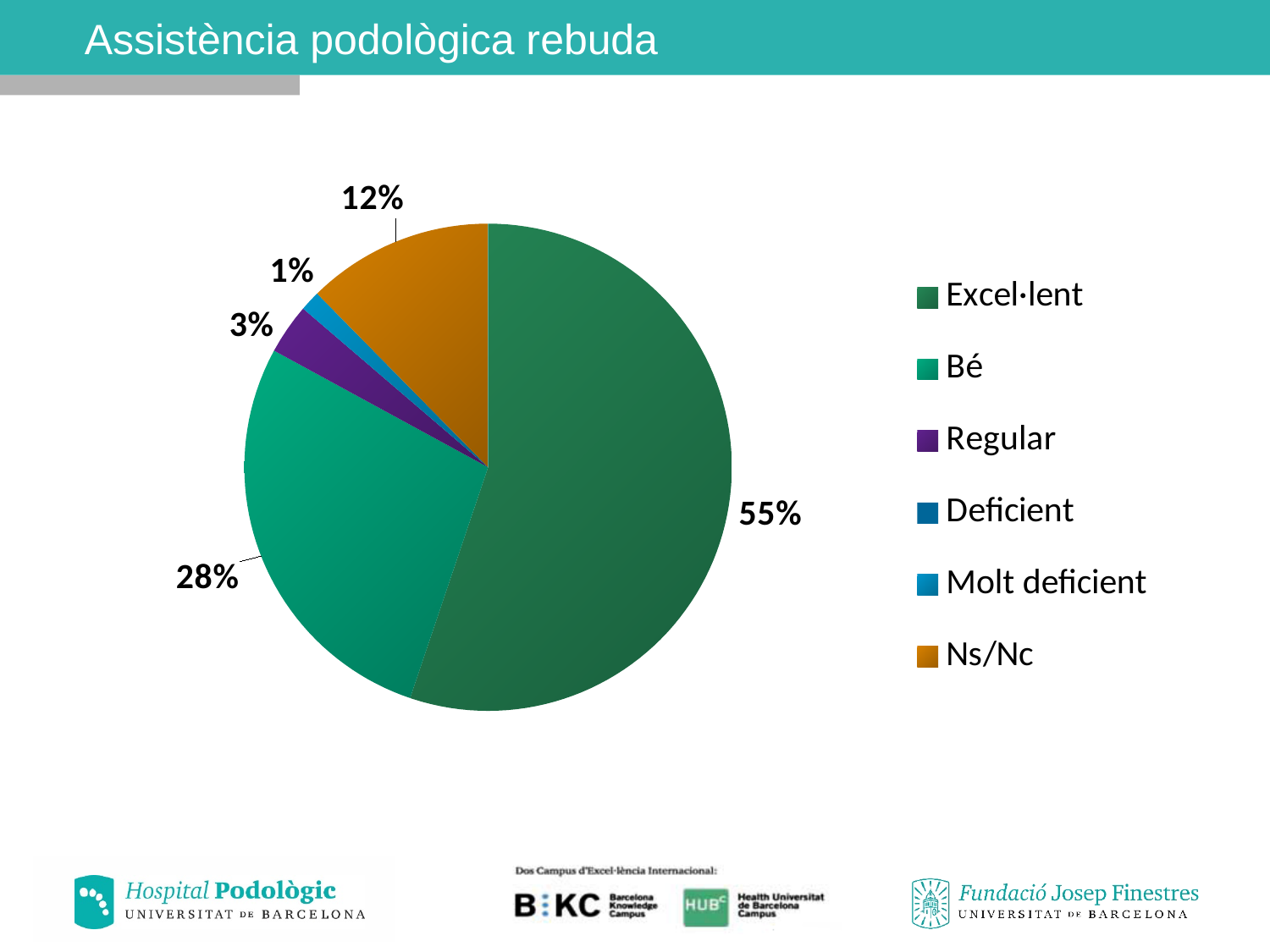
What percentage of the pie corresponds to Regular? 3% What colour is the Ns/Nc slice? orange Which is larger, the share for Bé or the share for Ns/Nc? Bé Which is larger, the share for Ns/Nc or the share for Regular? Ns/Nc How many categories does the legend list? 6 Which category has the largest share of the pie? Excel·lent What percentage of the pie corresponds to Bé? 28% What percentage of the pie corresponds to Ns/Nc? 12% What type of chart is shown on the slide? pie chart What is the difference in percentage points between Excel·lent and Bé? 27 What is the title of the slide? Assistència podològica rebuda What percentage of the pie corresponds to Excel·lent? 55%